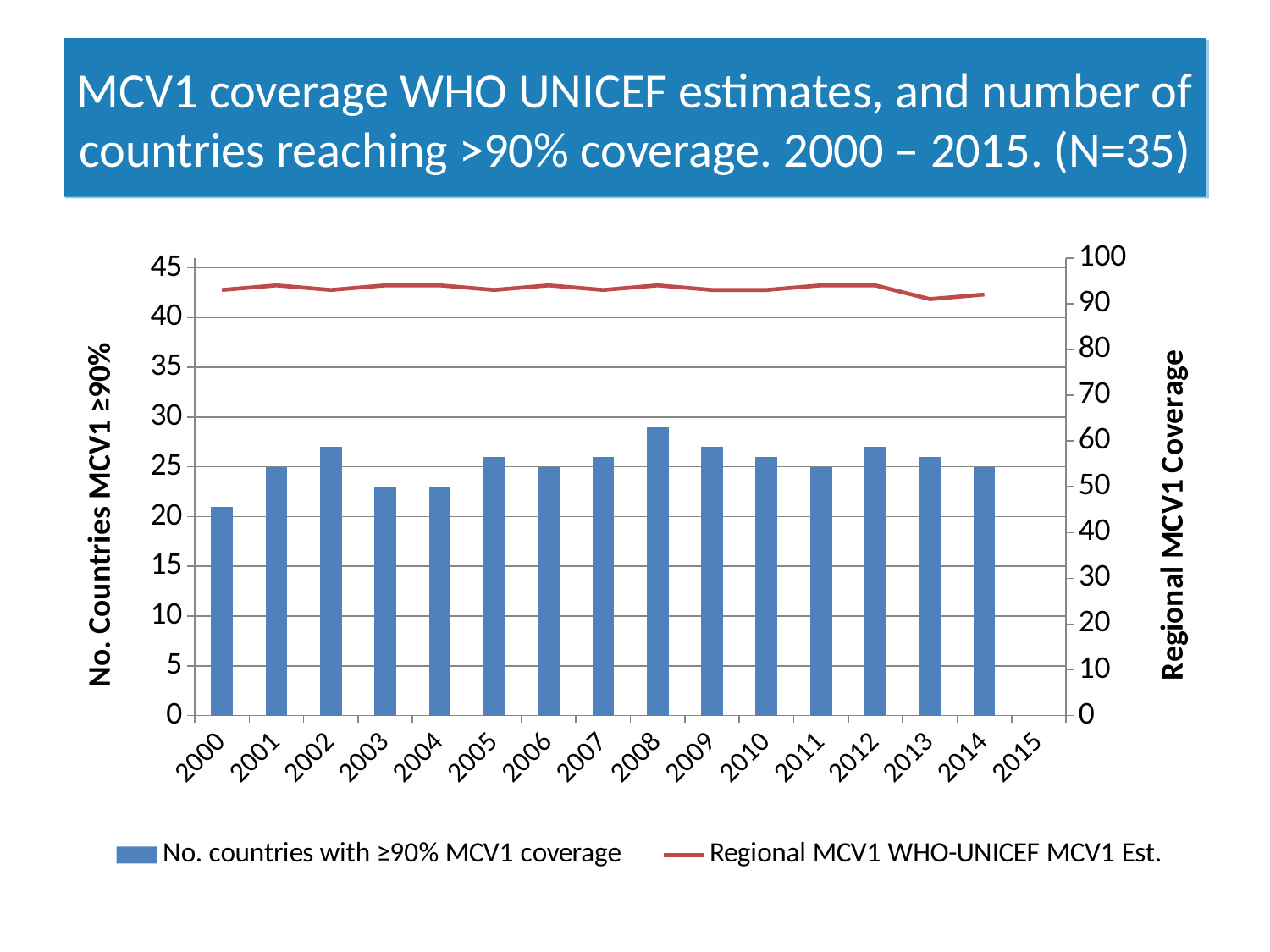
Which year has the highest number of countries with ≥90% MCV1 coverage? 2008 How many years are shown on the x axis? 16 Which year has the lowest number of countries with ≥90% MCV1 coverage? 2000 Is the Regional MCV1 WHO-UNICEF estimate in 2008 greater or less than 80? greater What kind of chart is shown on the slide? Bar chart combined with a line What is the number of countries with ≥90% MCV1 coverage in 2001? 25 How many series does the legend list? 2 Which year had more countries with ≥90% MCV1 coverage, 2002 or 2003? 2002 What is the number of countries with ≥90% MCV1 coverage in 2014? 25 What is the title of the left vertical axis? No. Countries MCV1 ≥90% Is the number of countries with ≥90% MCV1 coverage in 2003 greater or less than 25? less Is the number of countries with ≥90% MCV1 coverage in 2008 greater or less than 25? greater